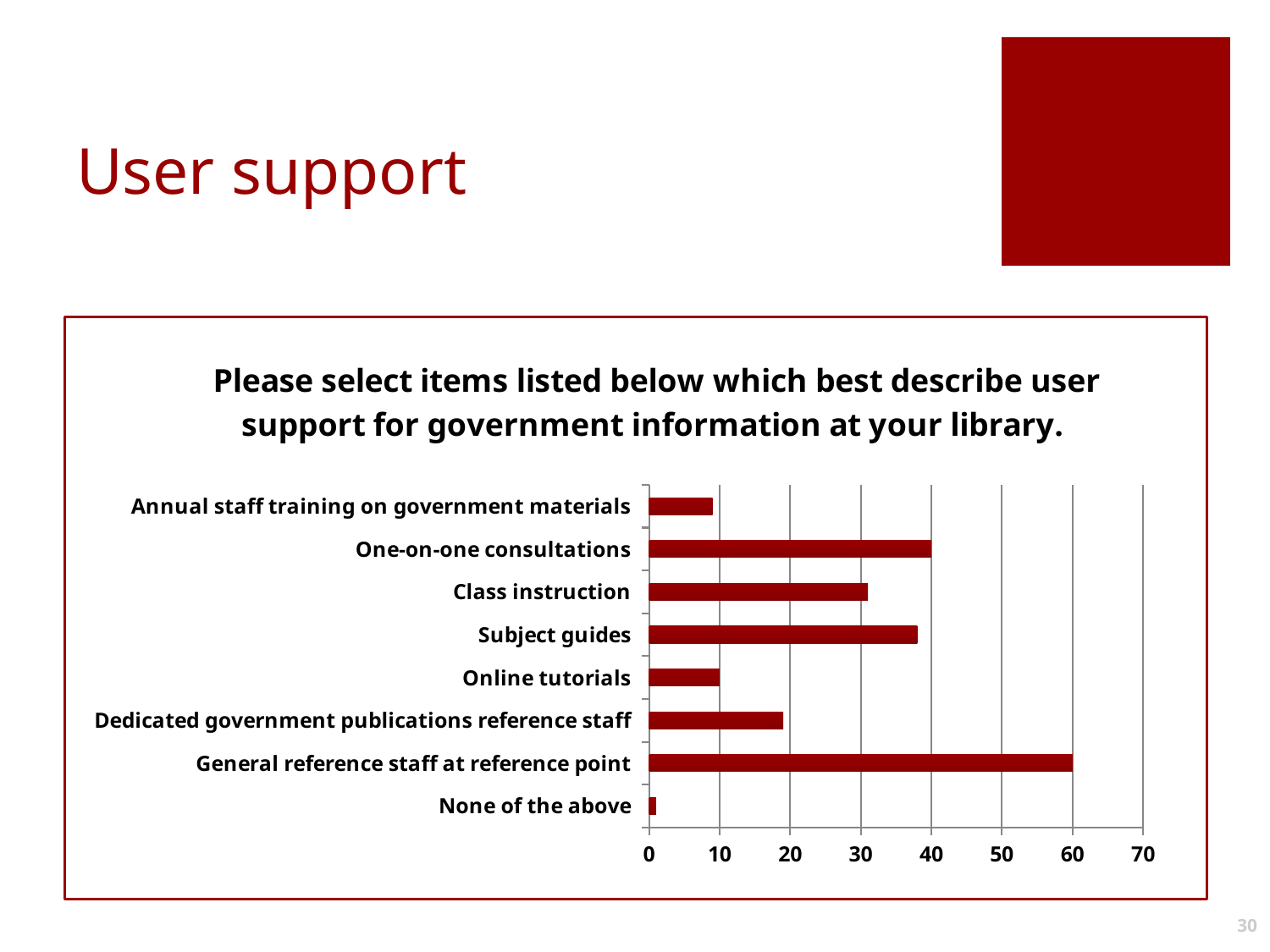
Is the value for Dedicated government publications reference staff greater or less than 20? less Is the value for Class instruction greater or less than 30? greater Which is larger, the value for Subject guides or the value for Class instruction? Subject guides What kind of chart is shown on the slide? bar chart Is the value for Annual staff training on government materials greater or less than 10? less How many categories are plotted in the chart? 8 What is the value for General reference staff at reference point? 60 Which category has the lowest value? None of the above Which is larger, the value for Dedicated government publications reference staff or the value for Online tutorials? Dedicated government publications reference staff Which category has the highest value? General reference staff at reference point What is the title of the chart? Please select items listed below which best describe user support for government information at your library.